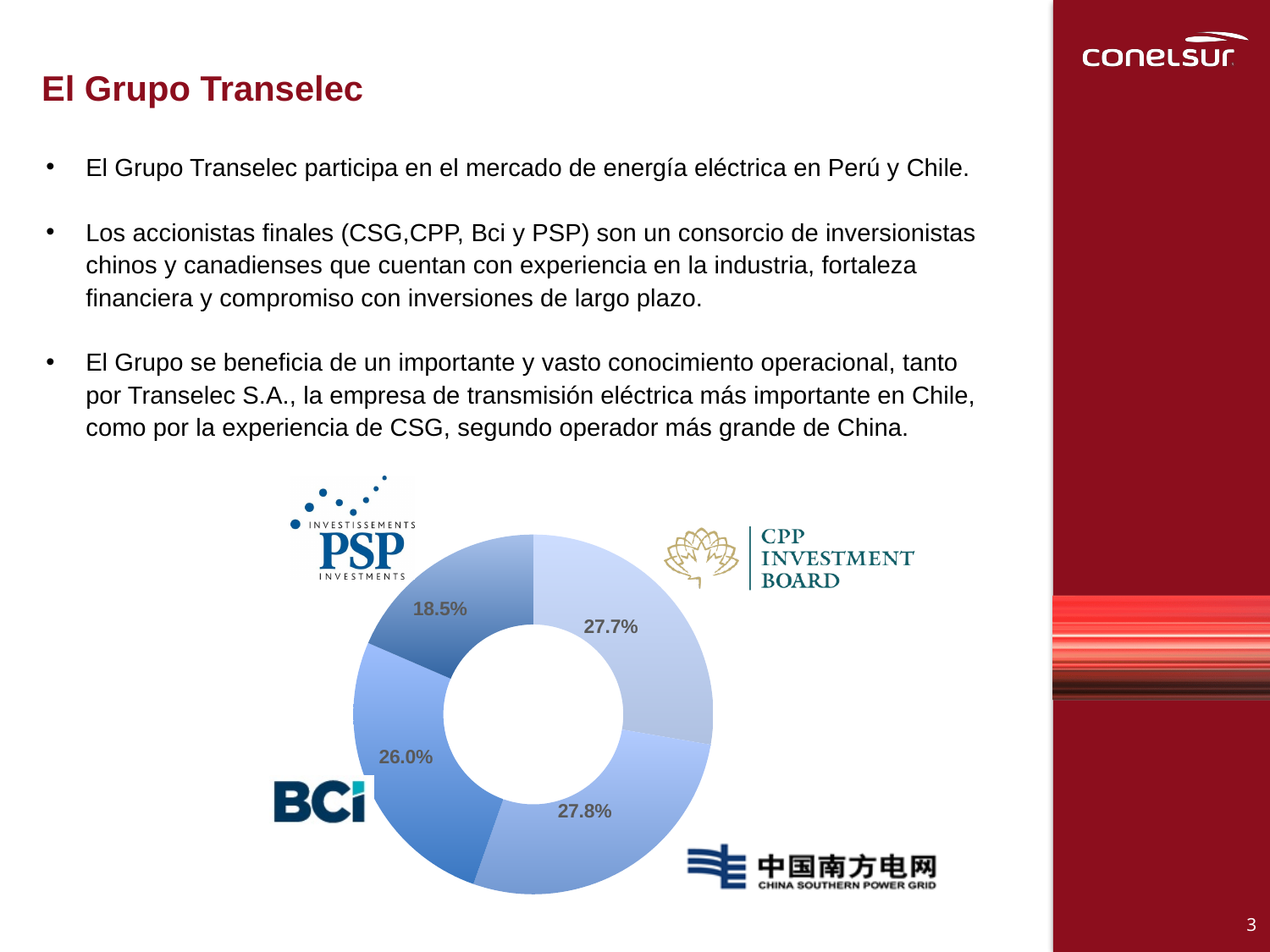
What percentage is shown for the slice next to the BCI logo? 26.0% How are the slices of the donut chart identified on the slide? By company logos placed next to each slice What percentage is shown for the slice next to the China Southern Power Grid logo? 27.8% Which shareholder has the smallest slice in the donut chart? PSP Investments What is the difference in percentage points between the China Southern Power Grid slice and the PSP Investments slice? 9.3 percentage points What is the difference in percentage points between the CPP Investment Board slice and the BCI slice? 1.7 percentage points Which shareholder has the largest slice in the donut chart? China Southern Power Grid What percentage is shown for the slice next to the CPP Investment Board logo? 27.7% What kind of chart is shown on the slide? Pie (donut) chart Which slice is larger, BCI or PSP Investments? BCI How many slices does the donut chart have? 4 What percentage is shown for the slice next to the PSP Investments logo? 18.5%